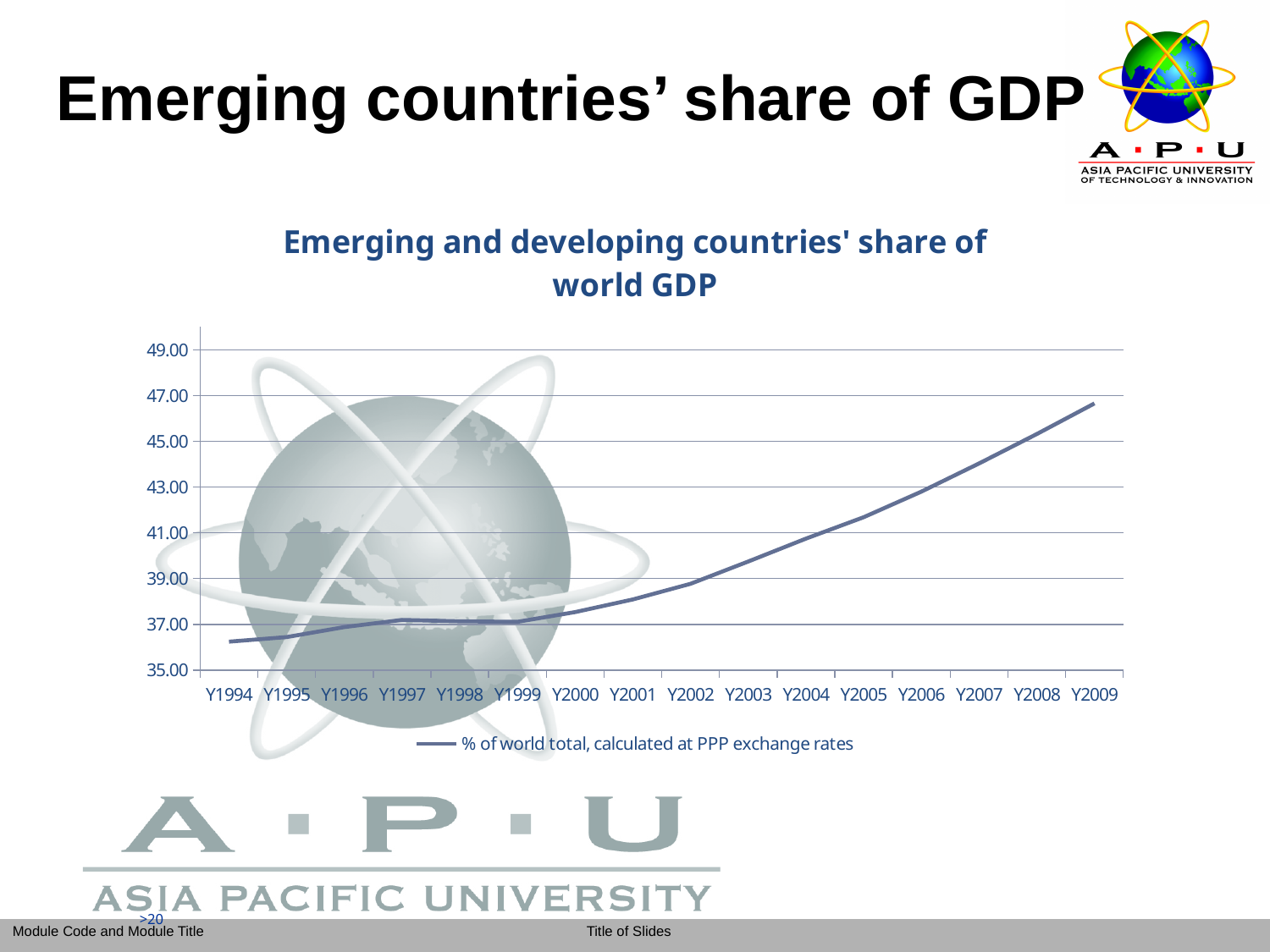
What is the title of the chart? Emerging and developing countries' share of world GDP What is the legend entry for the plotted line? % of world total, calculated at PPP exchange rates Which year has the highest value? Y2009 How many years are shown on the x axis? 16 Which year has the lowest value? Y1994 Is the value for Y2009 greater or less than 45.00? greater What kind of chart is shown on the slide? line chart How many series does the legend list? 1 Is the value for Y1994 greater or less than 37.00? less Is the value for Y2005 greater or less than 41.00? greater Which is larger, the value for Y2009 or the value for Y1994? Y2009 Do the values generally rise or fall from Y1994 to Y2009? rise